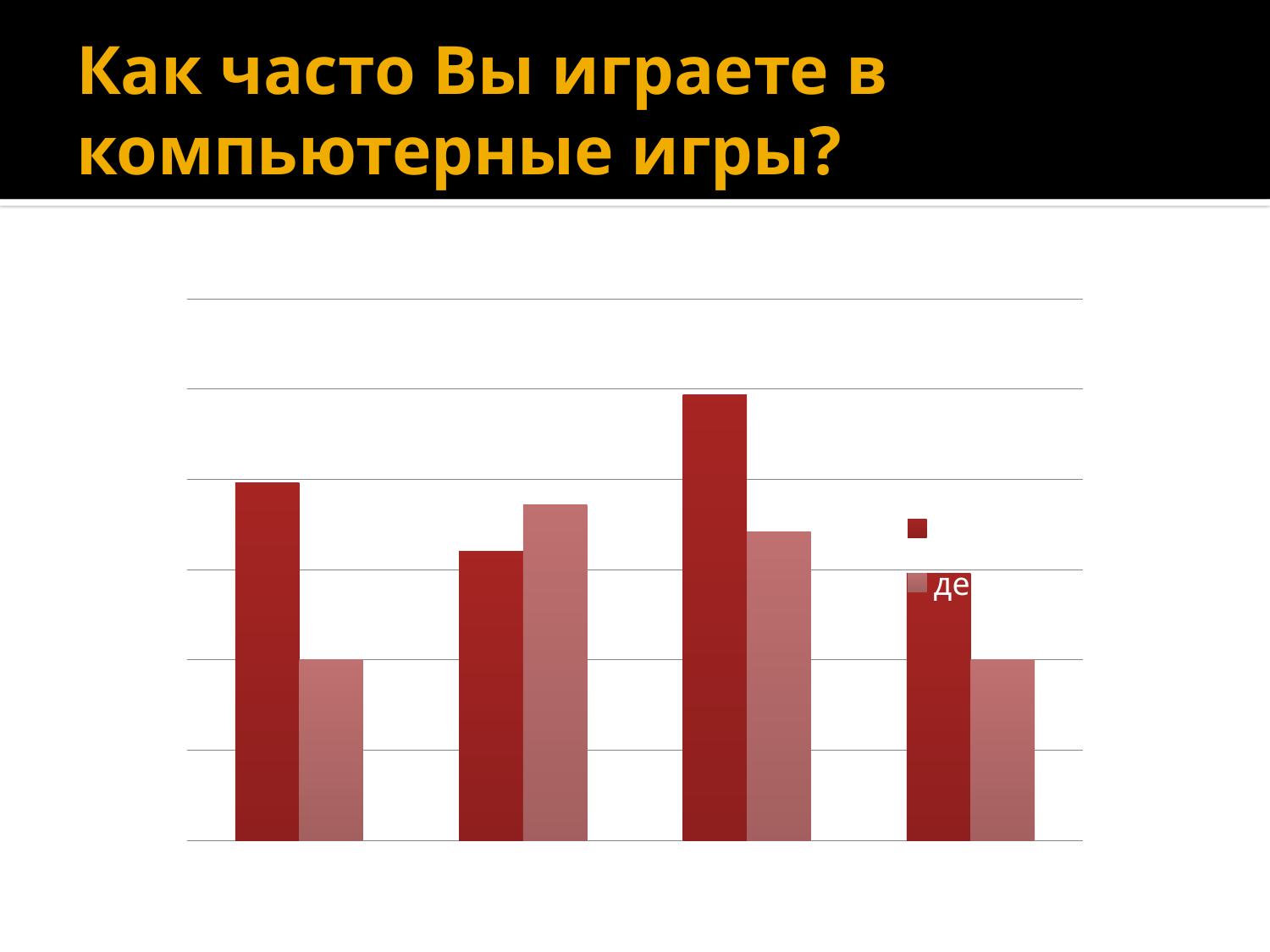
Which group of bars from the left has the tallest light red bar? the second group In the third group of bars from the left, which bar is taller, the dark red one or the light red one? the dark red one In the second group of bars from the left, which bar is taller, the dark red one or the light red one? the light red one What colours are the two series of bars on the chart? dark red and light red What kind of chart is shown on the slide? bar chart Which group of bars from the left contains the tallest bar on the chart? the third group How many groups of bars are plotted on the chart? 4 In the first group of bars from the left, which bar is taller, the dark red one or the light red one? the dark red one What is the title of the slide containing the chart? Как часто Вы играете в компьютерные игры? How many series does the chart's legend list? 2